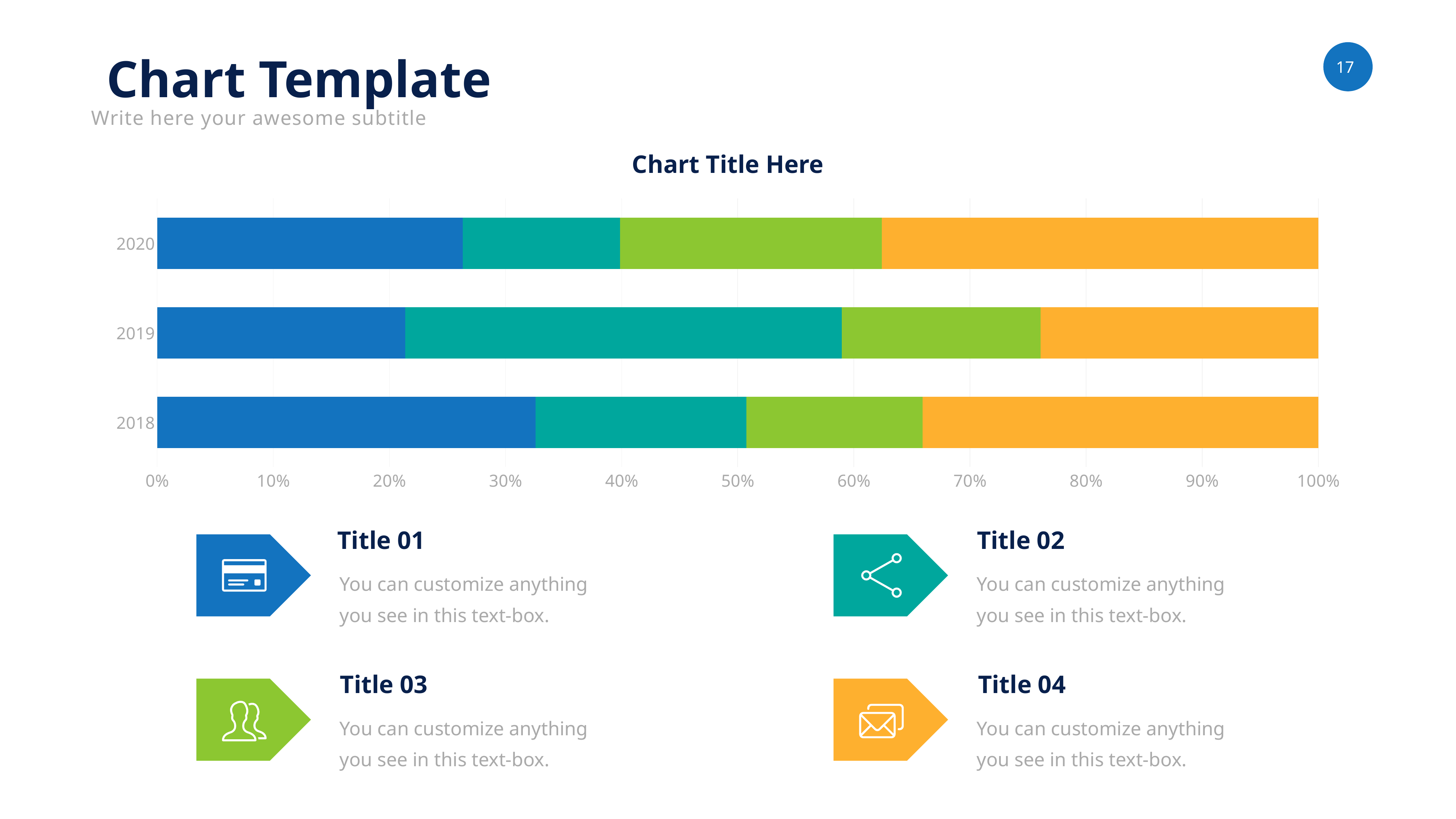
Is the blue segment for 2018 greater or less than 30%? greater What type of chart is shown on the slide? bar chart Is the blue segment for 2019 greater or less than 30%? less Which year has the largest teal segment? 2019 What is the title of the chart? Chart Title Here Is the green segment larger for 2020 or for 2018? 2020 Which year has the smallest orange segment? 2019 Is the blue segment for 2020 greater or less than 30%? less How many categories (years) are shown on the chart's vertical axis? 3 Which year has the largest blue segment? 2018 How many coloured segments make up each stacked bar in the chart? 4 What is the highest value shown on the chart's horizontal axis? 100%